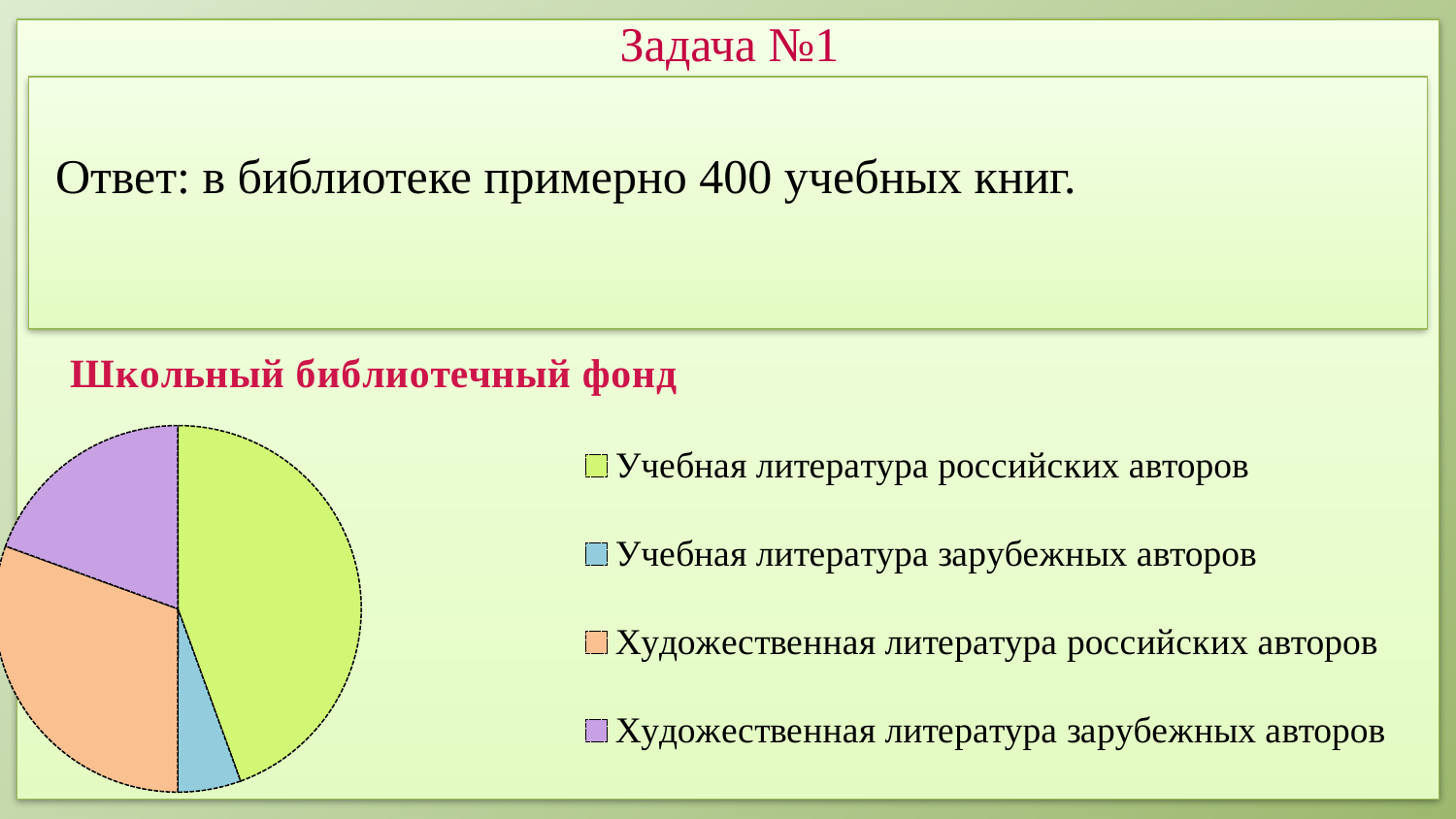
Which slice is larger: Учебная литература российских авторов or Художественная литература российских авторов? Учебная литература российских авторов Which category has the largest slice of the pie? Учебная литература российских авторов Which slice is larger: Художественная литература российских авторов or Художественная литература зарубежных авторов? Художественная литература российских авторов What kind of chart is shown on the slide? Pie chart How many entries does the legend list? 4 Which category has the smallest slice of the pie? Учебная литература зарубежных авторов What colour is the slice for Художественная литература зарубежных авторов? Purple Which slice is larger: Учебная литература зарубежных авторов or Художественная литература зарубежных авторов? Художественная литература зарубежных авторов How many slices does the pie chart have? 4 What is the title of the chart? Школьный библиотечный фонд